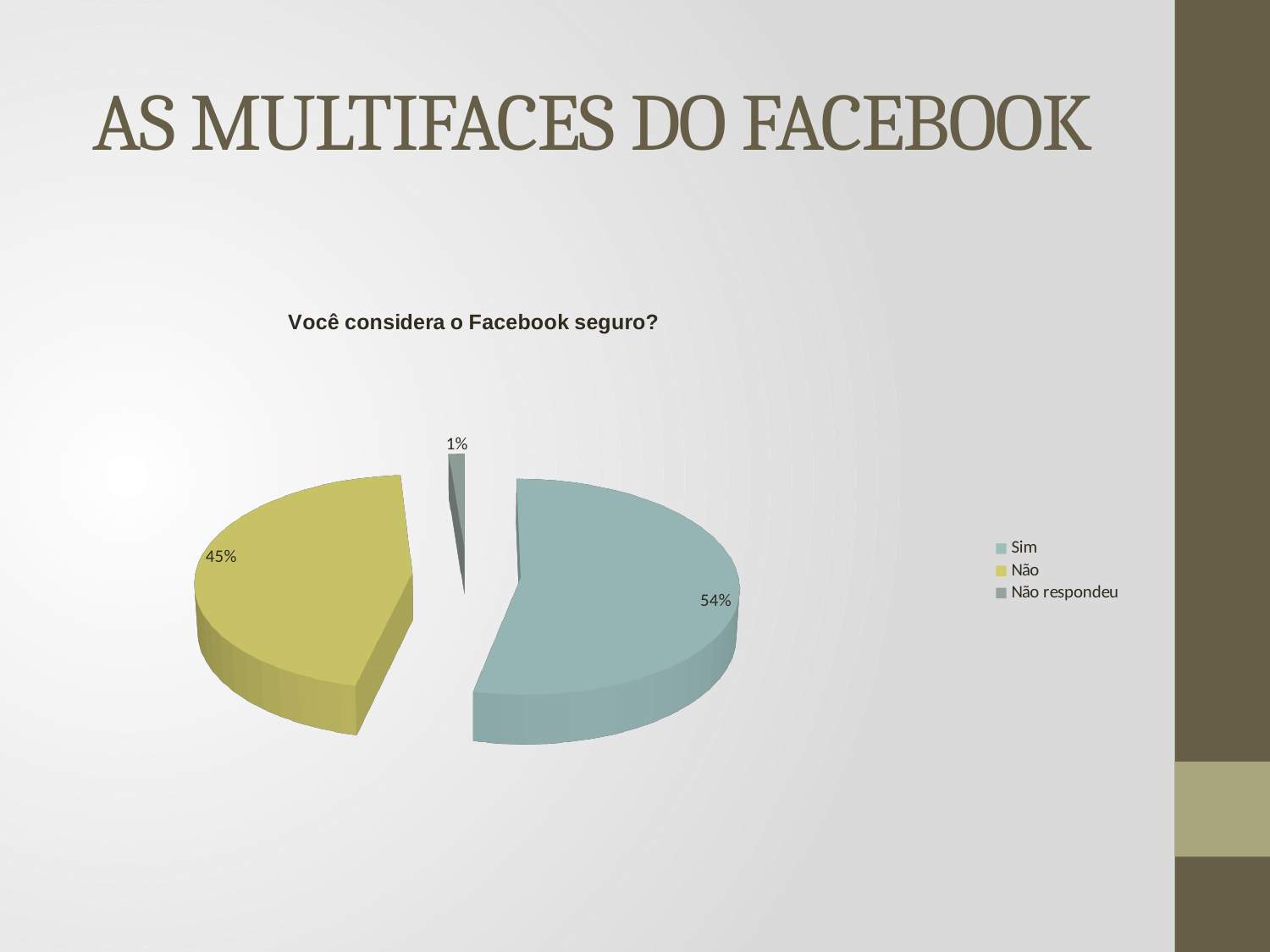
What is the chart's title? Você considera o Facebook seguro? What colour is the "Não" slice? Yellow-green Which category has the largest share of the pie? Sim What percentage of respondents answered "Sim"? 54% What percentage is shown for "Não respondeu"? 1% How many categories does the legend list? 3 What is the difference in percentage points between "Não" and "Não respondeu"? 44 Which is larger, the share for "Sim" or the share for "Não"? Sim What percentage of respondents answered "Não"? 45% What is the difference in percentage points between "Sim" and "Não"? 9 Which category has the smallest share of the pie? Não respondeu What kind of chart is shown on the slide? Pie chart